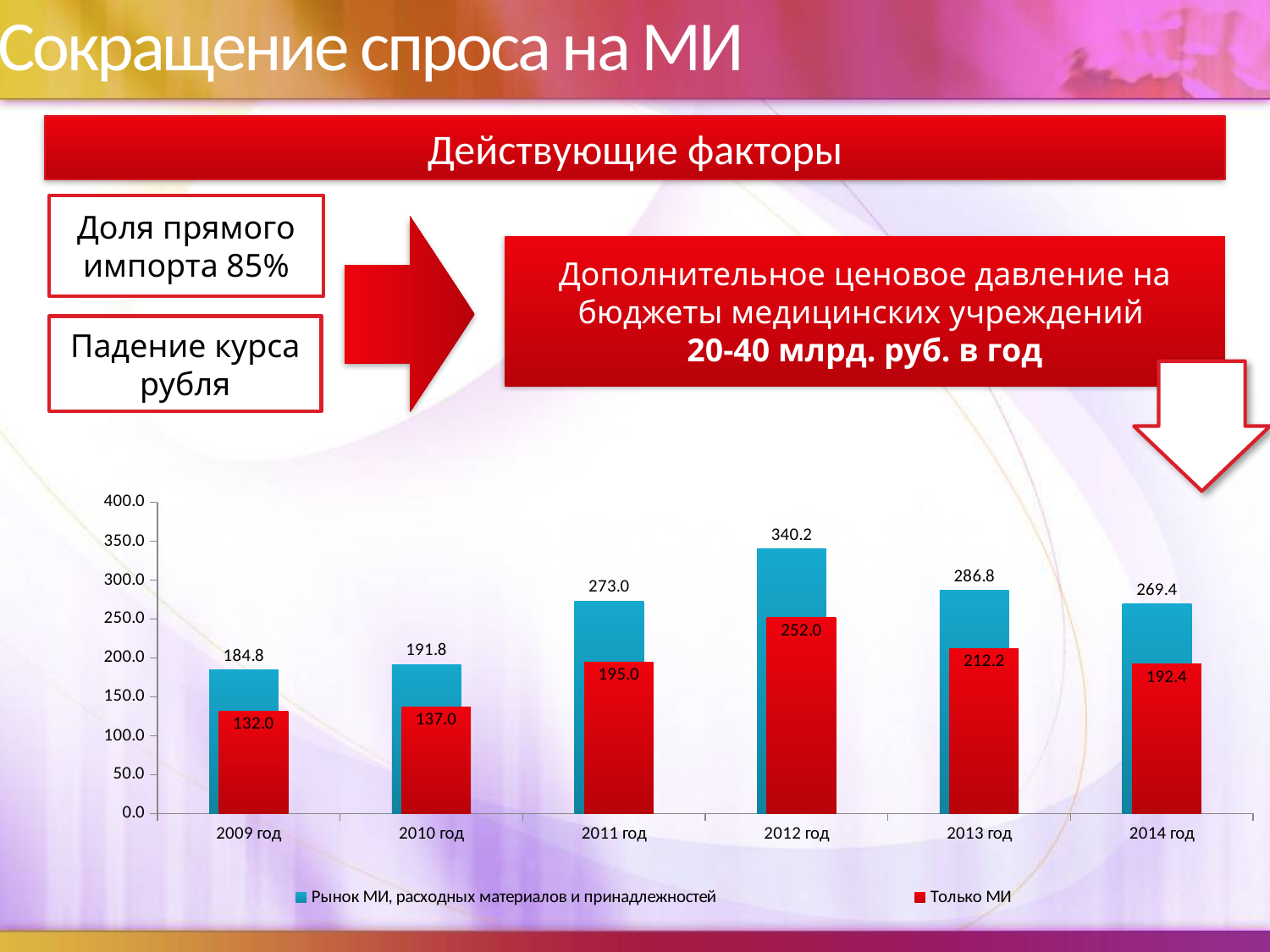
In which year is the value for "Только МИ" lowest? 2009 год What is the value for "Только МИ" in 2014 год? 192.4 What is the difference between the "Рынок МИ, расходных материалов и принадлежностей" value and the "Только МИ" value in 2013 год? 74.6 How many series does the chart legend list? 2 What is the value for "Только МИ" in 2010 год? 137.0 How many years are shown on the x axis of the chart? 6 Does the value for "Рынок МИ, расходных материалов и принадлежностей" rise or fall from 2012 год to 2014 год? fall In which year is the value for "Рынок МИ, расходных материалов и принадлежностей" highest? 2012 год What is the value for "Рынок МИ, расходных материалов и принадлежностей" in 2012 год? 340.2 Is the value for "Только МИ" in 2011 год greater or less than 200.0? less What type of chart is shown on the slide? bar chart Which is larger: the "Только МИ" value in 2012 год or the "Рынок МИ, расходных материалов и принадлежностей" value in 2014 год? Рынок МИ, расходных материалов и принадлежностей in 2014 год